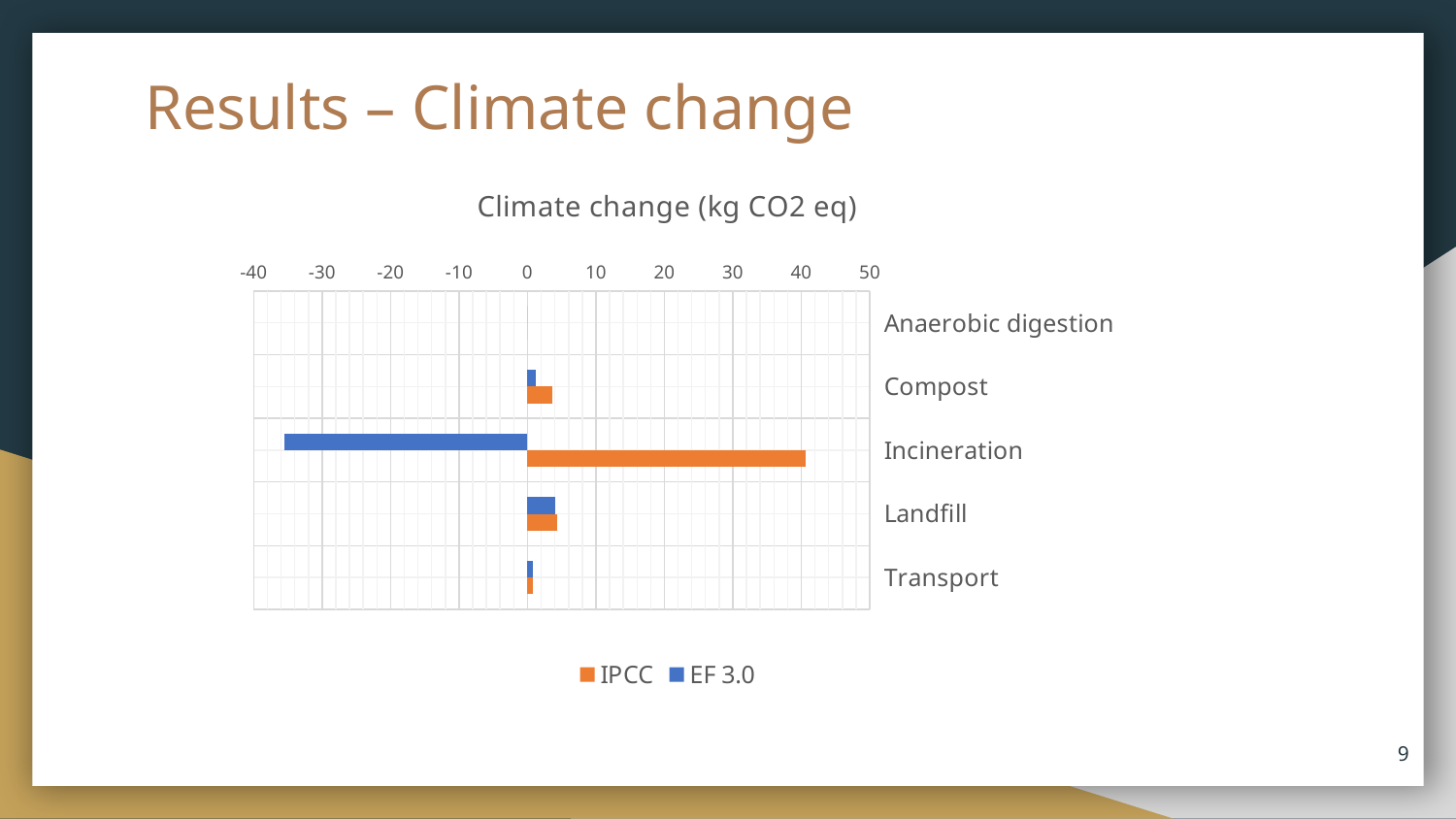
Is the EF 3.0 value for Incineration greater or less than -30? less Which series is shown in orange? IPCC Is the IPCC value for Incineration greater or less than 30? greater Which category has the lowest EF 3.0 value? Incineration How many categories are shown on the chart? 5 Which category has the highest IPCC value? Incineration Which is larger, the EF 3.0 value for Landfill or the EF 3.0 value for Transport? Landfill What is the title of the chart? Climate change (kg CO2 eq) Which is larger, the IPCC value for Incineration or the IPCC value for Landfill? Incineration How many series does the legend list? 2 Is the IPCC value for Compost greater or less than 10? less What kind of chart is shown on the slide? Bar chart